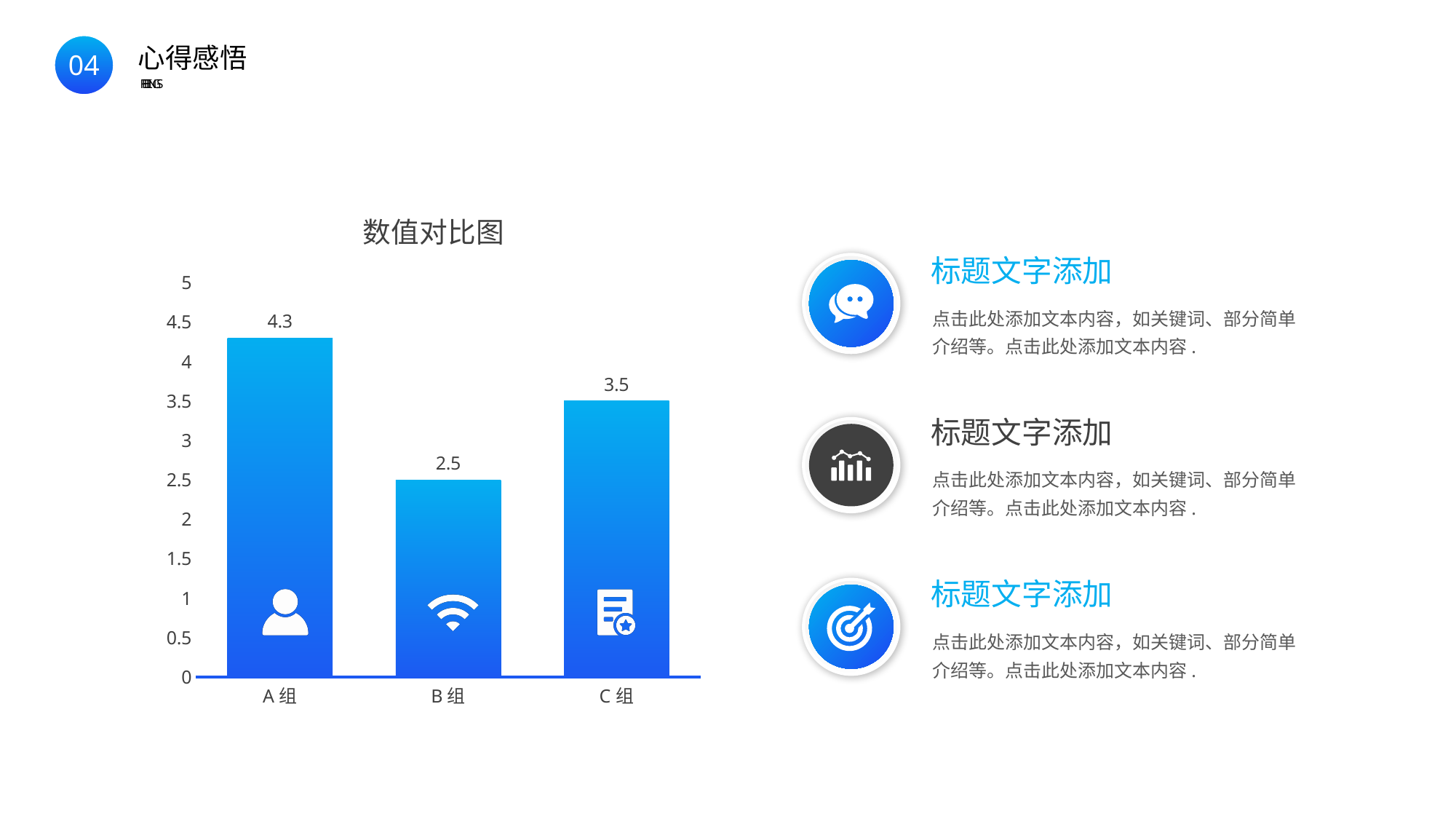
What is the value for C 组? 3.5 What is the value for B 组? 2.5 What kind of chart is shown on the slide? bar chart How many categories are shown on the x axis? 3 What is the value for A 组? 4.3 Which is larger, the value for A 组 or the value for C 组? A 组 What is the difference between the values for A 组 and B 组? 1.8 What is the difference between the values for C 组 and B 组? 1 Which category has the highest value? A 组 Which category has the lowest value? B 组 What is the title of the chart? 数值对比图 Is the value for C 组 greater or less than 3? greater